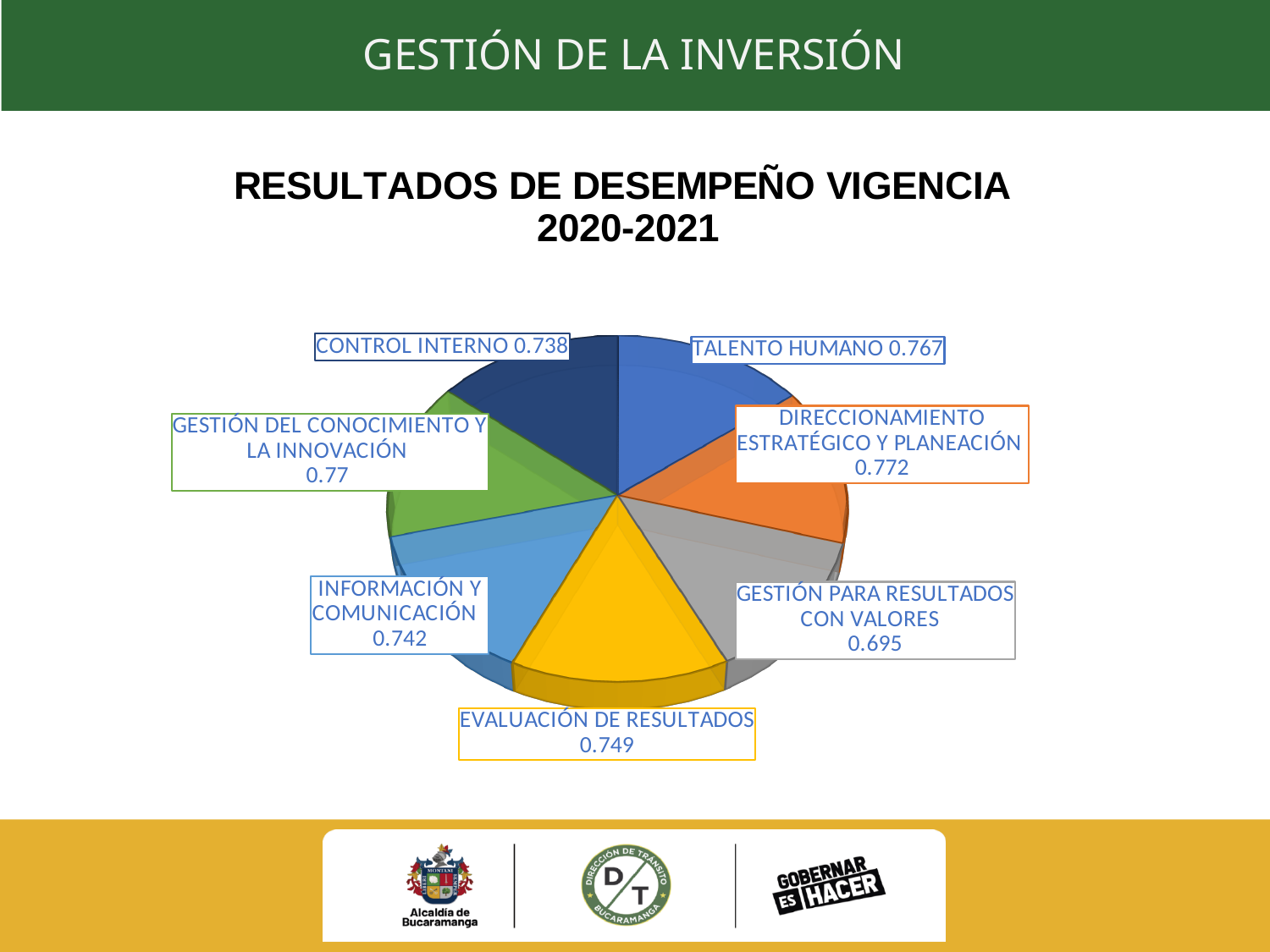
Which category has the highest value in the pie chart? DIRECCIONAMIENTO ESTRATÉGICO Y PLANEACIÓN Which has a larger value, EVALUACIÓN DE RESULTADOS or INFORMACIÓN Y COMUNICACIÓN? EVALUACIÓN DE RESULTADOS What is the value shown for CONTROL INTERNO? 0.738 What is the value shown for GESTIÓN PARA RESULTADOS CON VALORES? 0.695 What is the value shown for INFORMACIÓN Y COMUNICACIÓN? 0.742 How many slices does the pie chart have? 7 What type of chart is shown on the slide? Pie chart What is the title shown above the pie chart? RESULTADOS DE DESEMPEÑO VIGENCIA 2020-2021 What is the difference between the values for DIRECCIONAMIENTO ESTRATÉGICO Y PLANEACIÓN and GESTIÓN PARA RESULTADOS CON VALORES? 0.077 What is the value shown for TALENTO HUMANO? 0.767 What colour is the EVALUACIÓN DE RESULTADOS slice? Yellow Which category has the lowest value in the pie chart? GESTIÓN PARA RESULTADOS CON VALORES